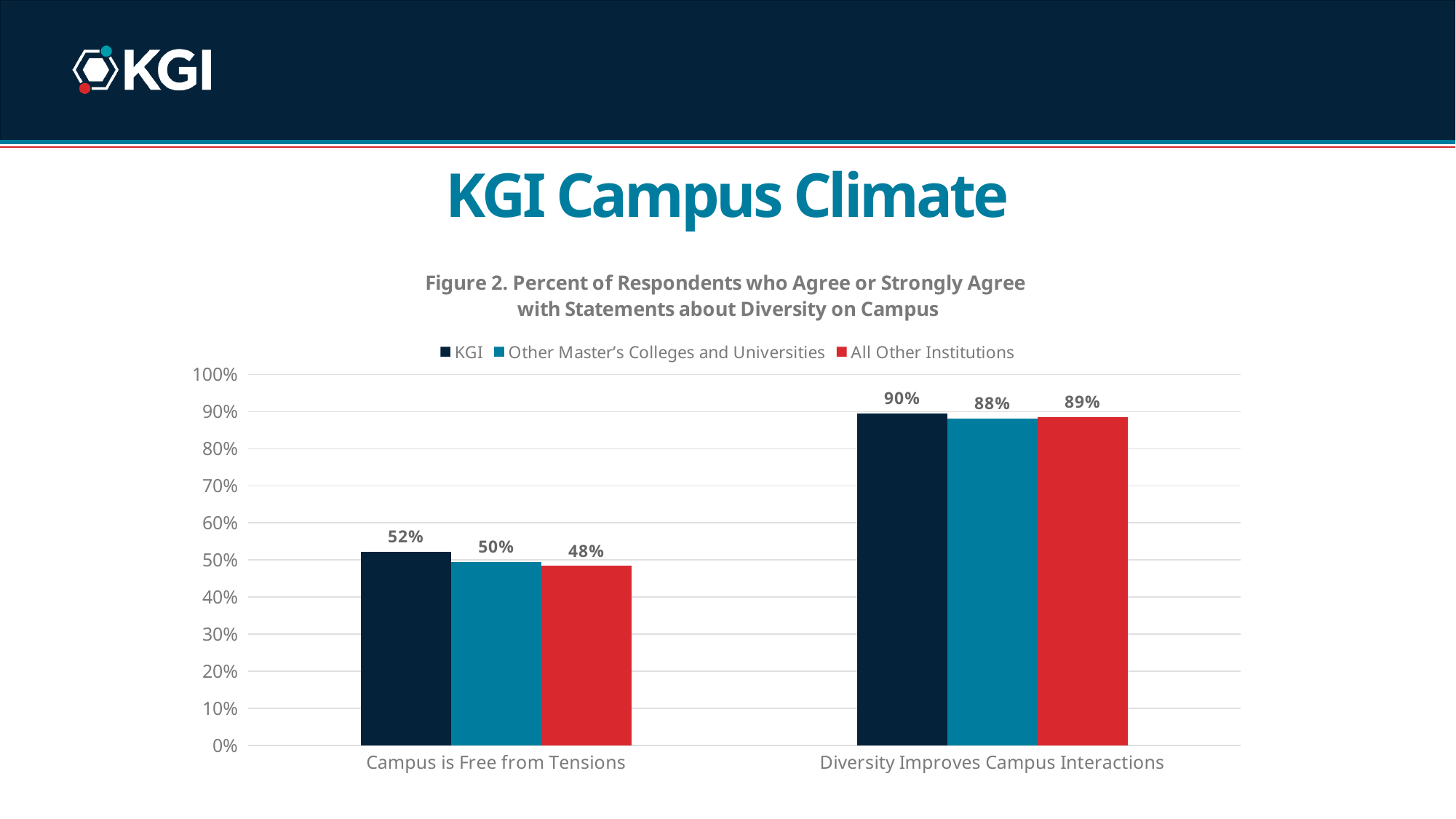
Which series has the highest value for Diversity Improves Campus Interactions? KGI What percentage of KGI respondents agree that Campus is Free from Tensions? 52% What is the value for All Other Institutions for Diversity Improves Campus Interactions? 89% How many series does the legend list? 3 What is the difference between the KGI value and the Other Master's Colleges and Universities value for Diversity Improves Campus Interactions? 2% Which is larger: the KGI value for Campus is Free from Tensions or the KGI value for Diversity Improves Campus Interactions? Diversity Improves Campus Interactions Which series has the lowest value for Campus is Free from Tensions? All Other Institutions What is the value for Other Master's Colleges and Universities for Campus is Free from Tensions? 50% What kind of chart is shown on the slide? Bar chart What is the difference between the KGI value and the All Other Institutions value for Campus is Free from Tensions? 4% How many categories are shown on the x axis? 2 What colour are the bars for All Other Institutions? Red